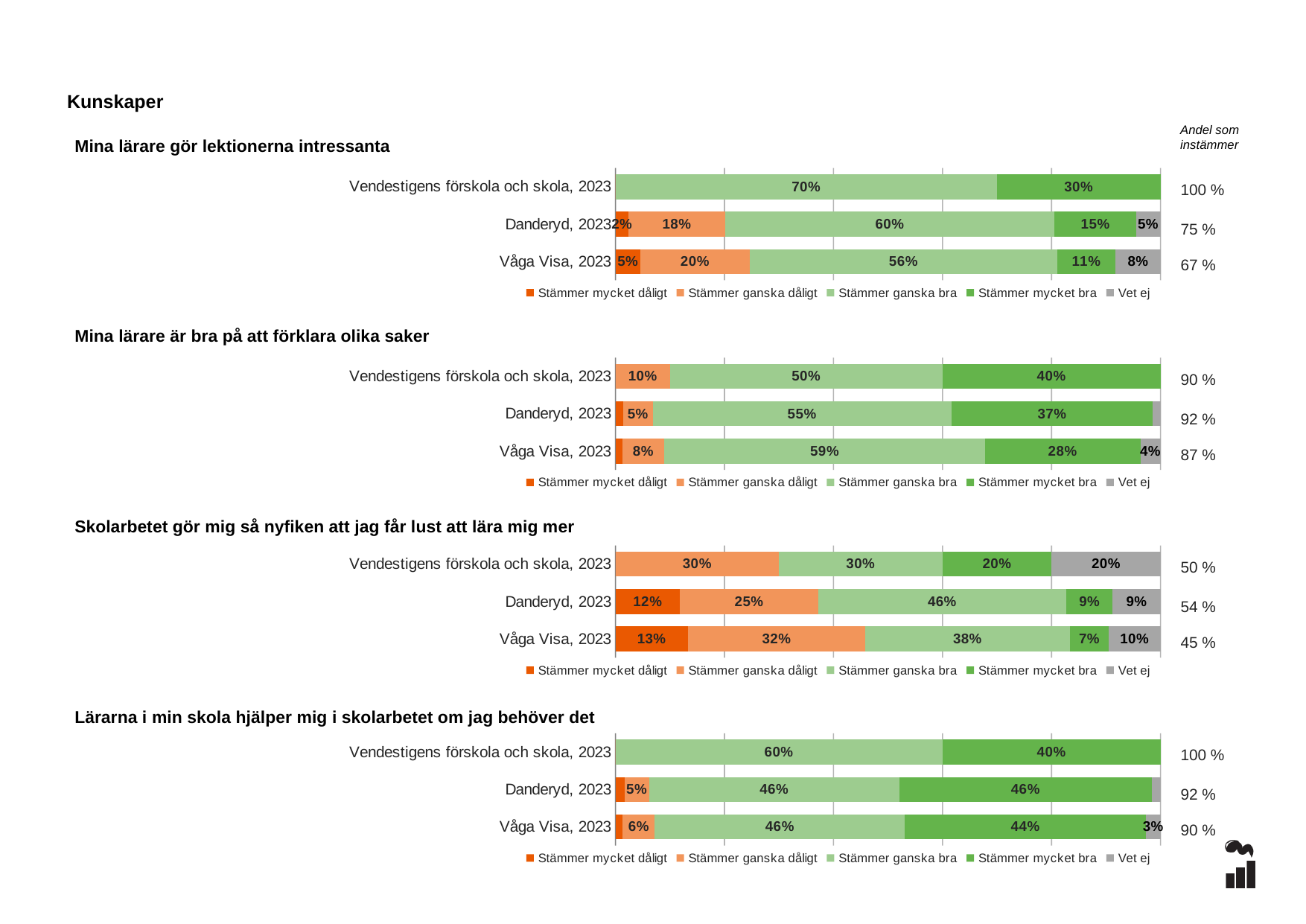
In the chart 'Mina lärare gör lektionerna intressanta', what is the 'Andel som instämmer' for Våga Visa, 2023? 67 % In the chart 'Lärarna i min skola hjälper mig i skolarbetet om jag behöver det', what is the 'Andel som instämmer' for Danderyd, 2023? 92 % In the chart 'Skolarbetet gör mig så nyfiken att jag får lust att lära mig mer', is the 'Stämmer ganska bra' value larger for Danderyd, 2023 or Våga Visa, 2023? Danderyd, 2023 In the chart 'Lärarna i min skola hjälper mig i skolarbetet om jag behöver det', what is the 'Stämmer mycket bra' value for Våga Visa, 2023? 44% What kind of chart is 'Skolarbetet gör mig så nyfiken att jag får lust att lära mig mer'? Stacked bar chart In the chart 'Mina lärare gör lektionerna intressanta', which row has the lowest 'Andel som instämmer'? Våga Visa, 2023 How many series does the legend list for the chart 'Mina lärare gör lektionerna intressanta'? 5 In the chart 'Mina lärare är bra på att förklara olika saker', what is the difference between the 'Stämmer mycket bra' values for Vendestigens förskola och skola, 2023 and Våga Visa, 2023? 12% In the chart 'Mina lärare gör lektionerna intressanta', what is the 'Stämmer ganska bra' value for Vendestigens förskola och skola, 2023? 70% In the chart 'Mina lärare är bra på att förklara olika saker', what is the 'Stämmer mycket bra' value for Danderyd, 2023? 37% In the chart 'Skolarbetet gör mig så nyfiken att jag får lust att lära mig mer', what is the 'Vet ej' value for Vendestigens förskola och skola, 2023? 20% In the chart 'Skolarbetet gör mig så nyfiken att jag får lust att lära mig mer', which row has the highest 'Stämmer mycket dåligt' value? Våga Visa, 2023